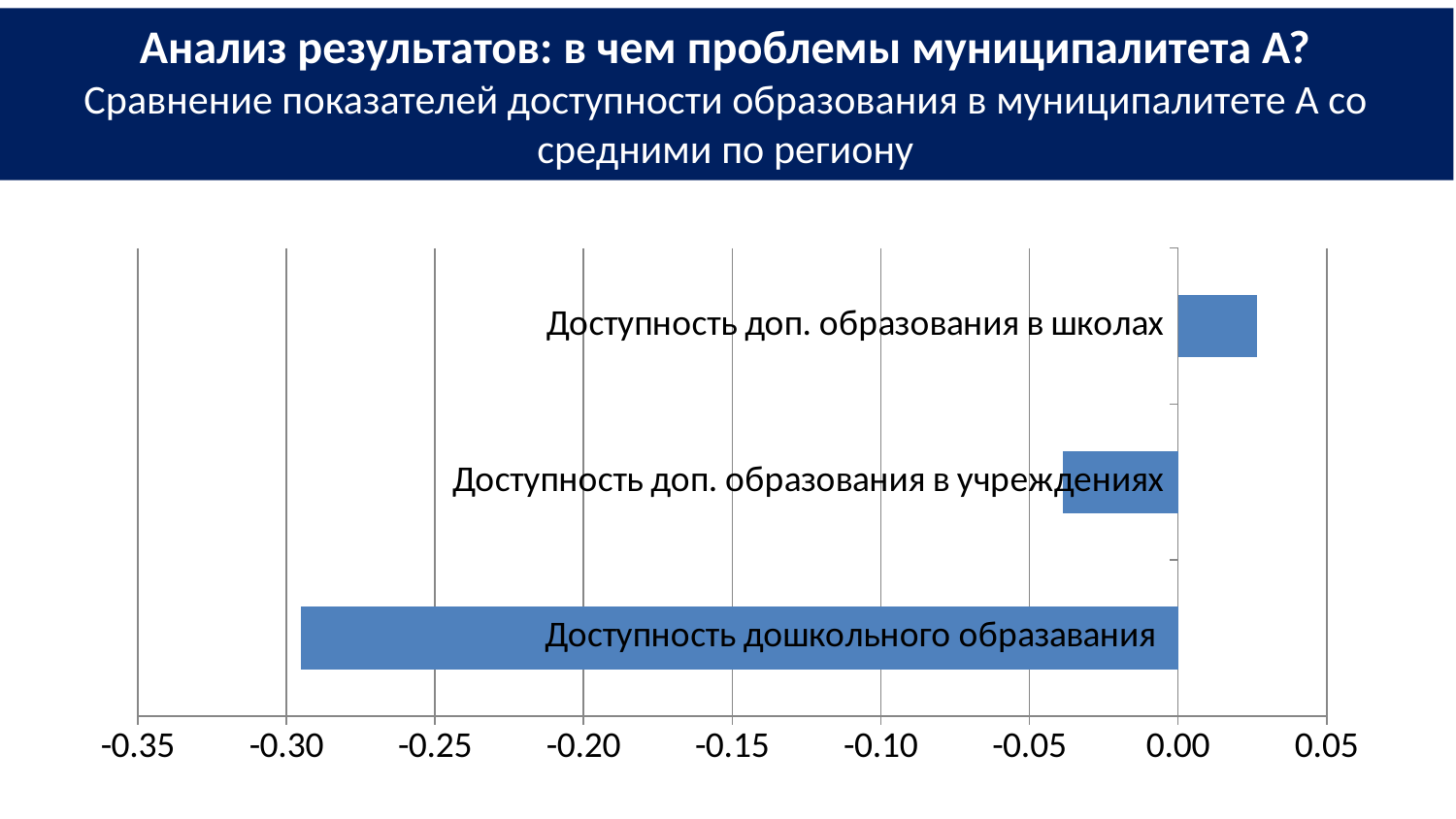
What is the lowest value shown on the horizontal axis of the chart? -0.35 Which category has the highest value in the chart? Доступность доп. образования в школах Is the value for Доступность дошкольного образавания greater or less than -0.35? greater Is the value for Доступность доп. образования в школах greater or less than 0.00? greater Is the value for Доступность дошкольного образавания greater or less than -0.25? less What kind of chart is shown on the slide? bar chart Which category is the only one with a positive value in the chart? Доступность доп. образования в школах Which category has the lowest value in the chart? Доступность дошкольного образавания Which is larger: the value for Доступность доп. образования в учреждениях or the value for Доступность дошкольного образавания? Доступность доп. образования в учреждениях How many categories are plotted in the chart? 3